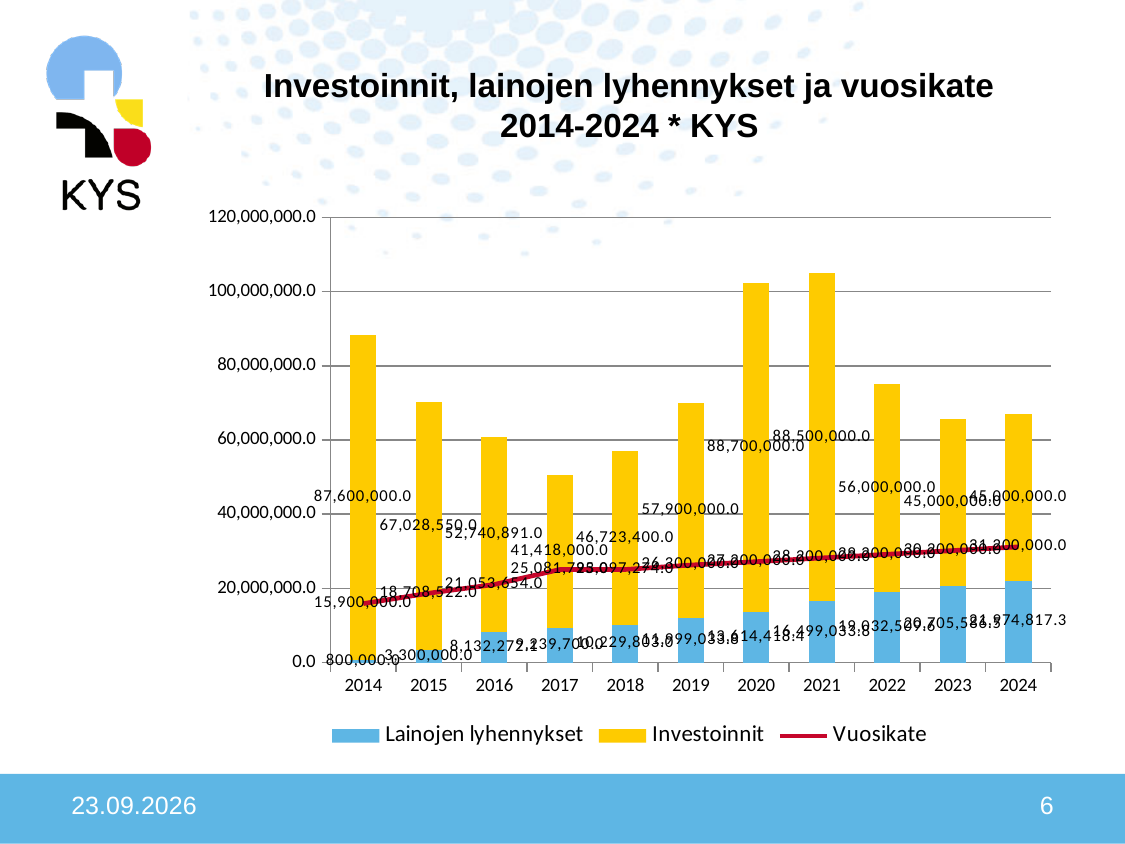
What is the Investoinnit value for 2014? 87,600,000.0 What is the Lainojen lyhennykset value for 2024? 21,974,817.3 What is the total of the stacked bar for 2014? 88,400,000.0 How many series does the chart legend list? 3 What is the difference between the Investoinnit values for 2014 and 2015? 20,571,450.0 Which year has the tallest stacked bar? 2021 Which year has the lowest Investoinnit value? 2017 What is the Vuosikate value for 2014? 15,900,000.0 How many years are shown on the x axis of the chart? 11 What type of chart is shown on the slide? Stacked bar chart with a line Do the Lainojen lyhennykset values rise or fall from 2014 to 2024? rise Is the total stacked bar for 2020 greater or less than 100,000,000.0? greater